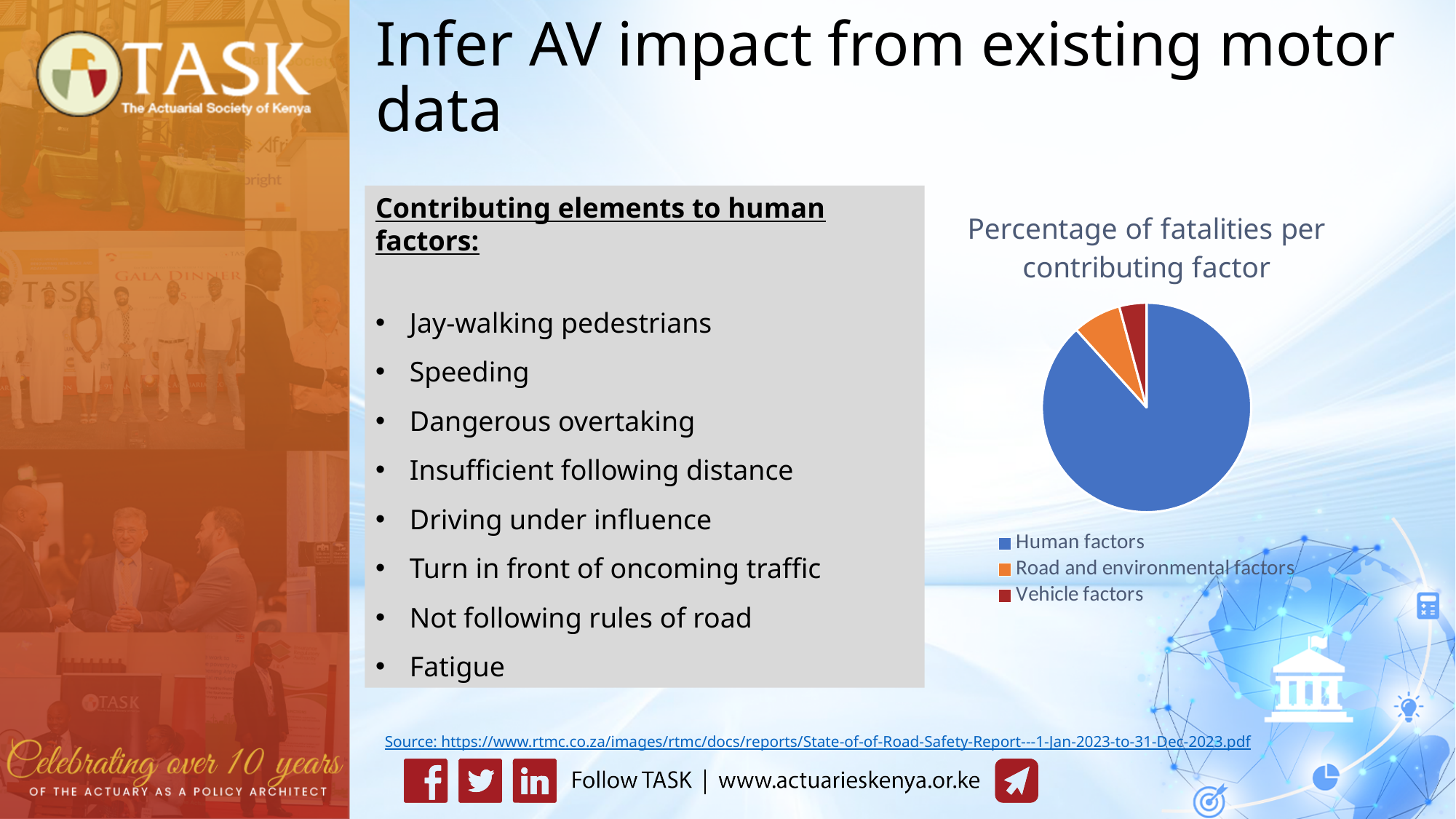
In the pie chart, which is larger: the share for Road and environmental factors or the share for Vehicle factors? Road and environmental factors How many slices does the pie chart have? 3 What is the title of the pie chart? Percentage of fatalities per contributing factor Which contributing factor accounts for the smallest share of fatalities in the pie chart? Vehicle factors How many entries does the legend of the pie chart list? 3 Which contributing factor accounts for the largest share of fatalities in the pie chart? Human factors What kind of chart is shown on the slide? Pie chart In the pie chart, which is larger: the share for Human factors or the share for Road and environmental factors? Human factors What colour represents Human factors in the pie chart? Blue